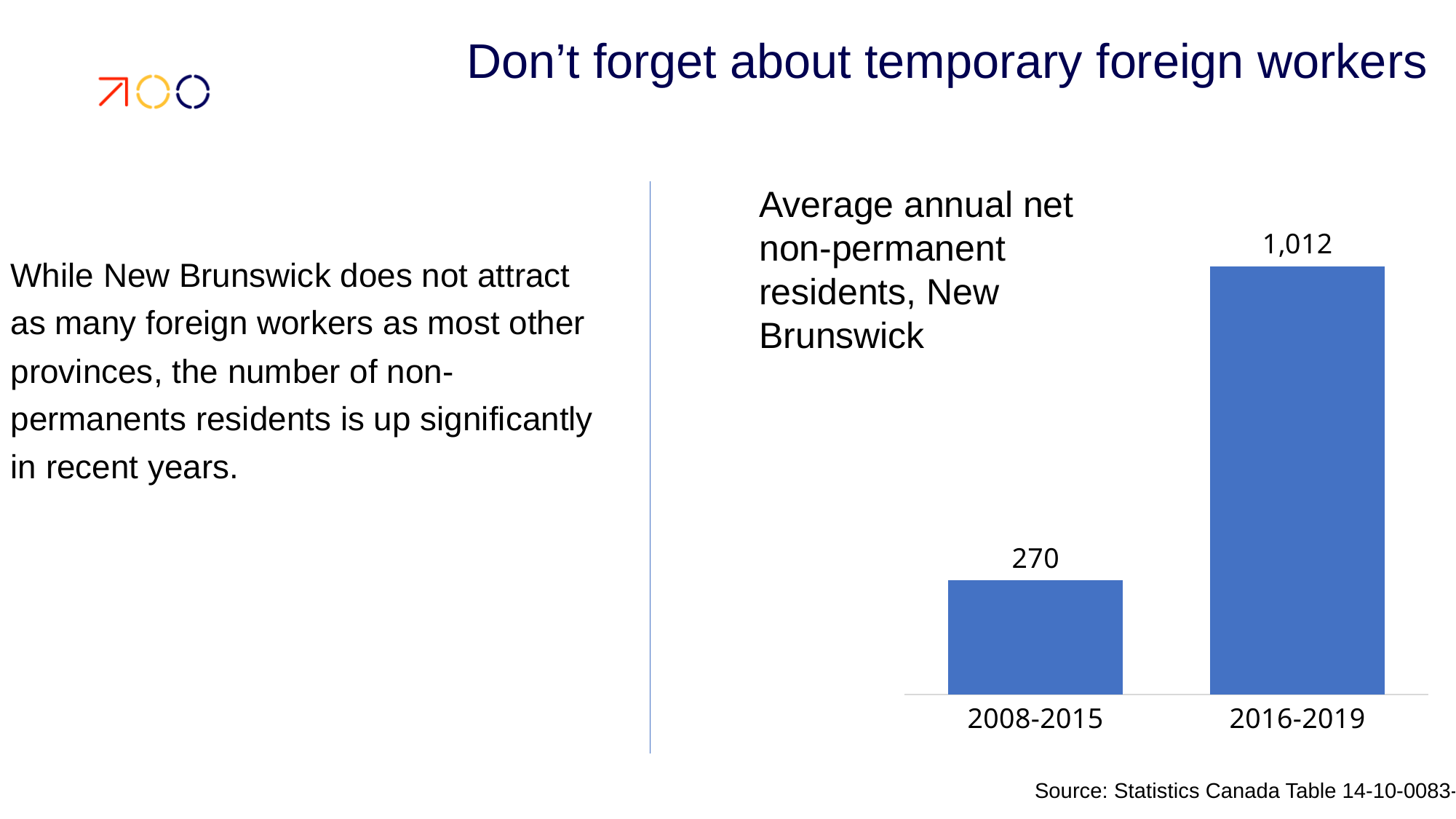
Which period has the higher average annual net non-permanent residents? 2016-2019 What is the average annual net non-permanent residents value for 2008-2015? 270 What is the difference between the 2016-2019 value and the 2008-2015 value? 742 Do the values rise or fall from 2008-2015 to 2016-2019? rise How many periods (bars) are shown in the chart? 2 What is the title of the chart? Average annual net non-permanent residents, New Brunswick Is the value for 2016-2019 larger or smaller than the value for 2008-2015? larger Which period has the lower average annual net non-permanent residents? 2008-2015 What colour are the bars in the chart? blue What is the average annual net non-permanent residents value for 2016-2019? 1,012 What kind of chart is shown on the slide? bar chart